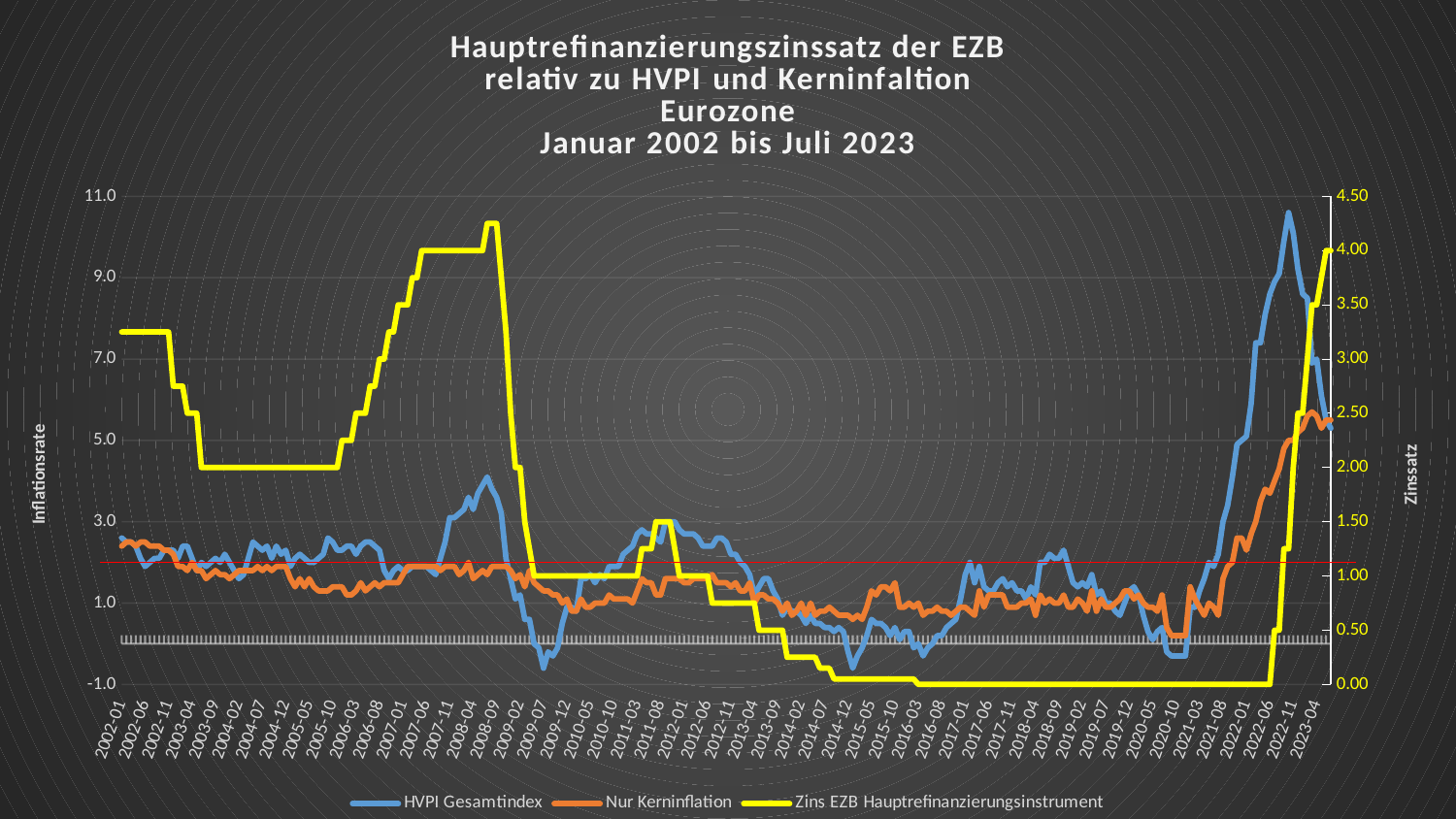
How many series does the legend list? 3 Which series is plotted in yellow? Zins EZB Hauptrefinanzierungsinstrument Is the peak value of Nur Kerninflation in 2023 greater or less than 5.0? greater What kind of chart is shown on the slide? line chart What is the value of Zins EZB Hauptrefinanzierungsinstrument in 2004-07? 2.00 Which series reaches the highest value on the left-hand inflation axis? HVPI Gesamtindex Is the value of Zins EZB Hauptrefinanzierungsinstrument at its 2008 peak greater or less than 4.00? greater Which is larger in 2022-11, HVPI Gesamtindex or Nur Kerninflation? HVPI Gesamtindex What is the label of the right-hand vertical axis? Zinssatz Does the HVPI Gesamtindex line rise or fall between 2021-08 and 2022-11? rise What is the value of Zins EZB Hauptrefinanzierungsinstrument in 2018-04? 0.00 Is the peak value of HVPI Gesamtindex in 2022 greater or less than 9.0? greater